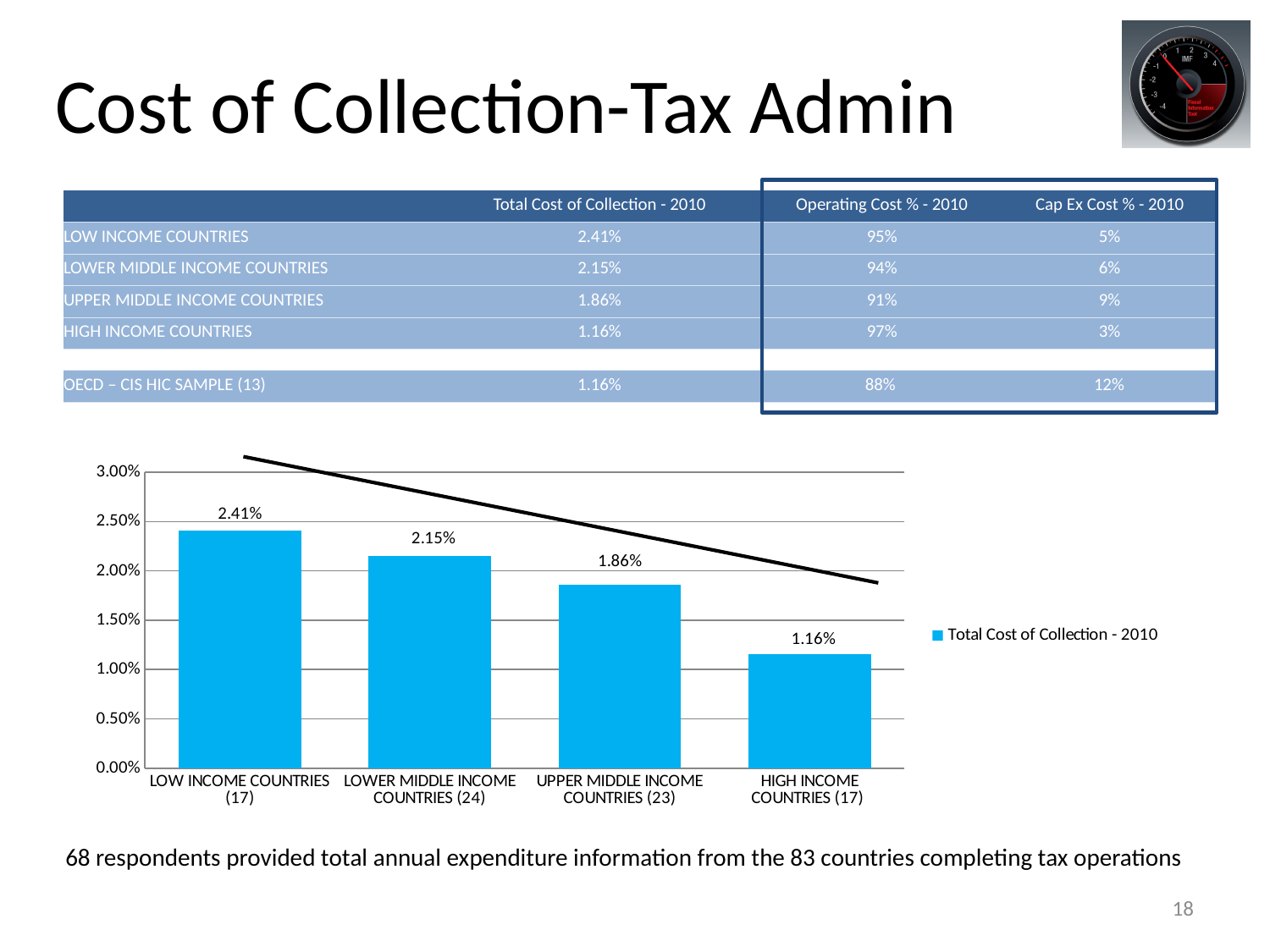
What is the Total Cost of Collection - 2010 for LOW INCOME COUNTRIES (17) in the bar chart? 2.41% What is the difference between the Total Cost of Collection - 2010 for LOW INCOME COUNTRIES (17) and HIGH INCOME COUNTRIES (17)? 1.25% What kind of chart is shown on the slide? bar chart How many series does the legend of the chart list? 1 Is the value for LOWER MIDDLE INCOME COUNTRIES (24) greater or less than 2.00%? greater What is the Total Cost of Collection - 2010 for HIGH INCOME COUNTRIES (17) in the bar chart? 1.16% Which category has the highest Total Cost of Collection - 2010 in the bar chart? LOW INCOME COUNTRIES (17) Do the values rise or fall from left to right along the x axis of the bar chart? fall What is the Total Cost of Collection - 2010 for UPPER MIDDLE INCOME COUNTRIES (23) in the bar chart? 1.86% Which category has the lowest Total Cost of Collection - 2010 in the bar chart? HIGH INCOME COUNTRIES (17) Which is larger in the bar chart: the value for LOWER MIDDLE INCOME COUNTRIES (24) or UPPER MIDDLE INCOME COUNTRIES (23)? LOWER MIDDLE INCOME COUNTRIES (24) How many categories are shown on the x axis of the bar chart? 4